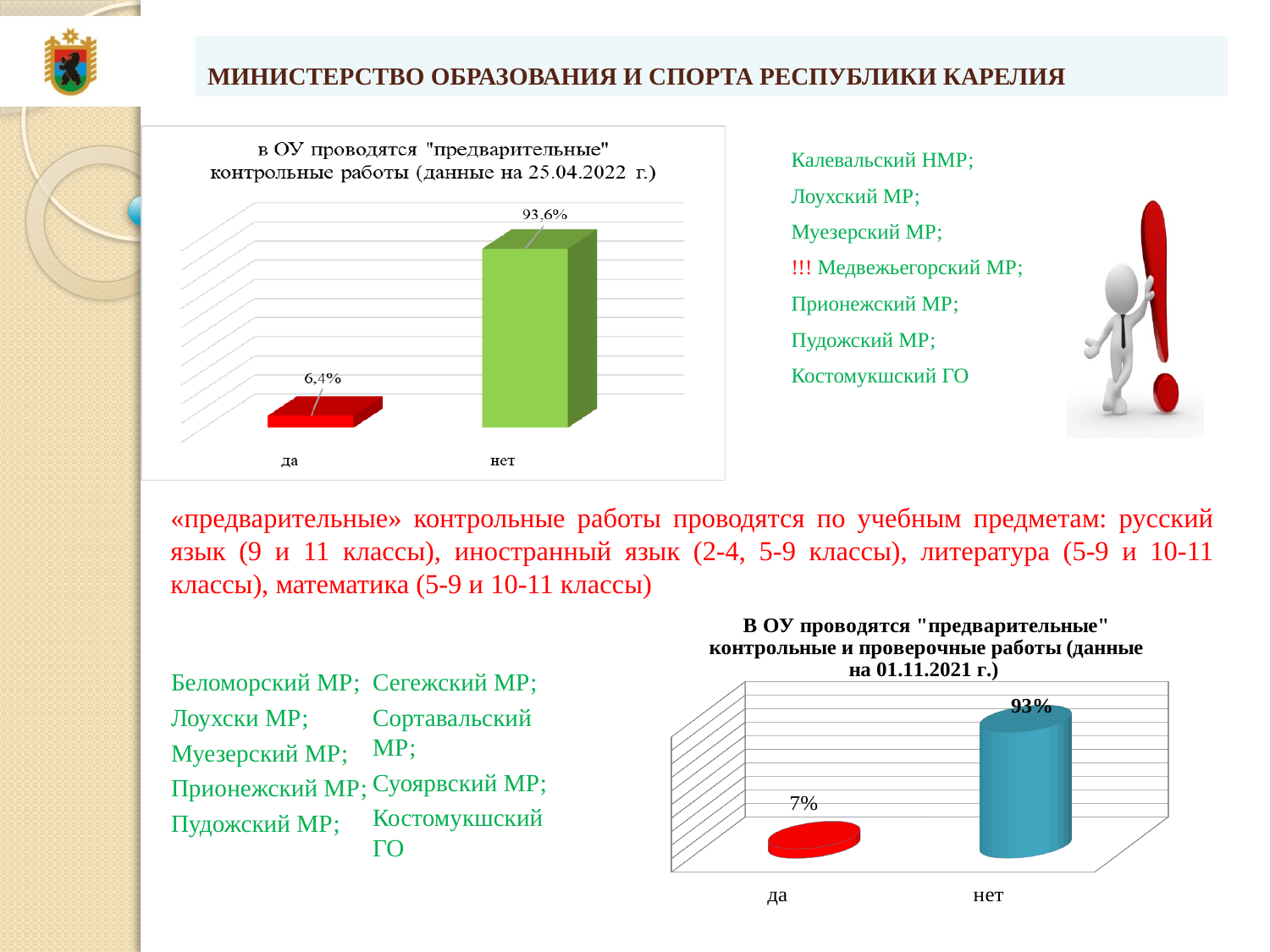
What type of chart is the top-left chart (data as of 25.04.2022)? bar chart In the bottom-right chart (data as of 01.11.2021), what is the difference between the values for "нет" and "да"? 86% In the top-left chart (data as of 25.04.2022), what is the value for "да"? 6,4% In the bottom-right chart (data as of 01.11.2021), which category has the lowest value? да In the top-left chart (data as of 25.04.2022), what is the value for "нет"? 93,6% In the top-left chart (data as of 25.04.2022), which category has the highest value? нет In the top-left chart (data as of 25.04.2022), how many categories are shown? 2 In the bottom-right chart (data as of 01.11.2021), what is the value for "да"? 7% In the bottom-right chart (data as of 01.11.2021), which is larger, the value for "да" or the value for "нет"? нет In the top-left chart (data as of 25.04.2022), what is the difference between the values for "нет" and "да"? 87,2% In the bottom-right chart (data as of 01.11.2021), what is the value for "нет"? 93% In the top-left chart (data as of 25.04.2022), what colour is the bar for "да"? red